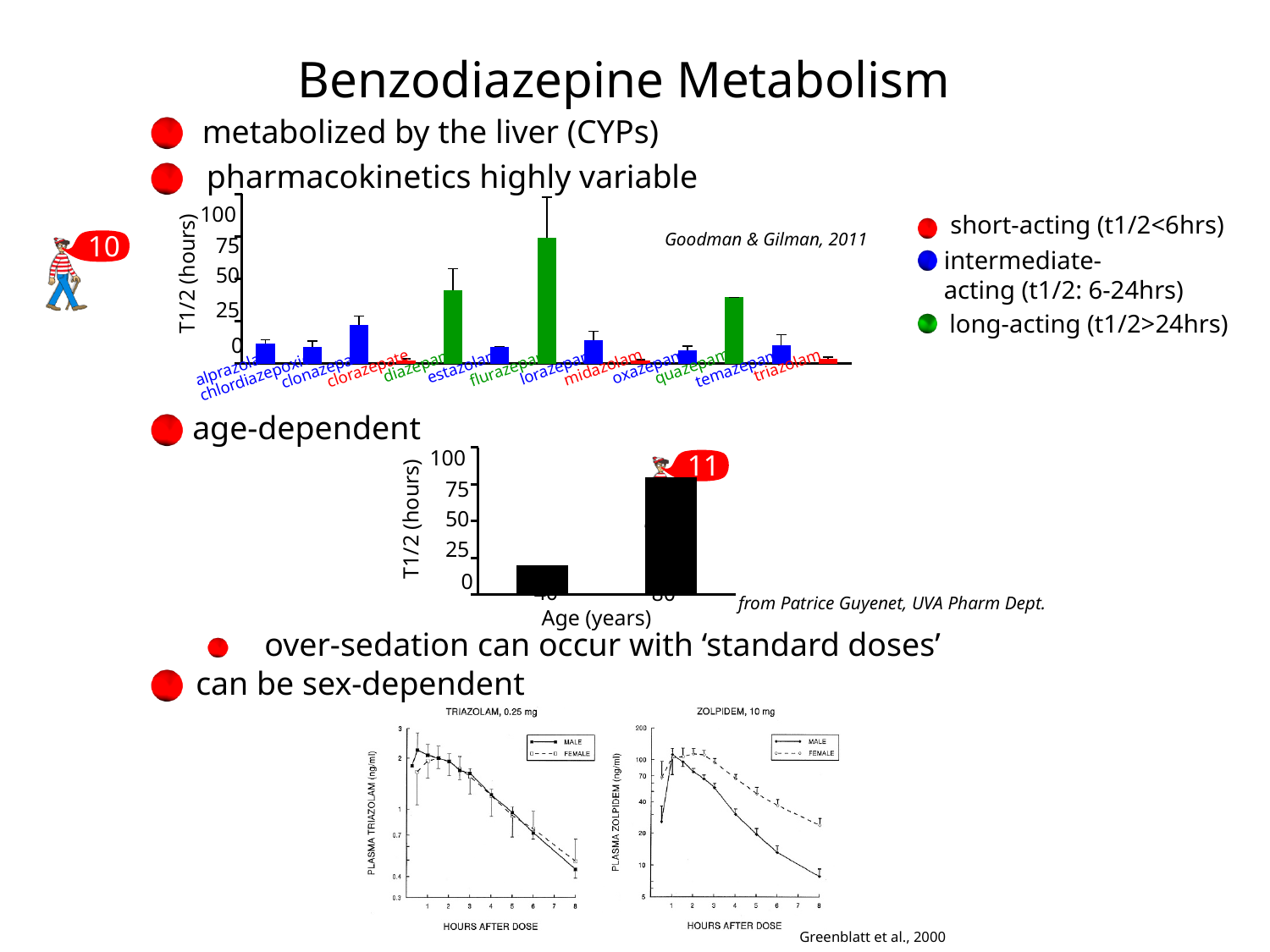
In the bottom-right line chart titled ZOLPIDEM, 10 mg, do plasma zolpidem values rise or fall as hours after dose increase beyond 2 hours? fall In the middle age-dependent chart of T1/2 (hours), is the value for the older age group greater or less than 50? greater In the top bar chart of T1/2 (hours), what colour are the bars for long-acting drugs according to the legend? green What kind of chart is the top chart showing T1/2 (hours) for benzodiazepines? bar chart In the top bar chart of T1/2 (hours), is the value for diazepam greater or less than 50? less In the bottom-right line chart titled ZOLPIDEM, 10 mg, how many series does the legend list? 2 In the top bar chart of T1/2 (hours), which is larger, the value for flurazepam or the value for quazepam? flurazepam In the top bar chart of T1/2 (hours), is the value for flurazepam greater or less than 50? greater In the top bar chart of T1/2 (hours) for benzodiazepines, which drug has the highest half-life? flurazepam In the middle age-dependent chart of T1/2 (hours) versus Age (years), how many bars are plotted? 2 How many drugs are plotted in the top bar chart of T1/2 (hours)? 13